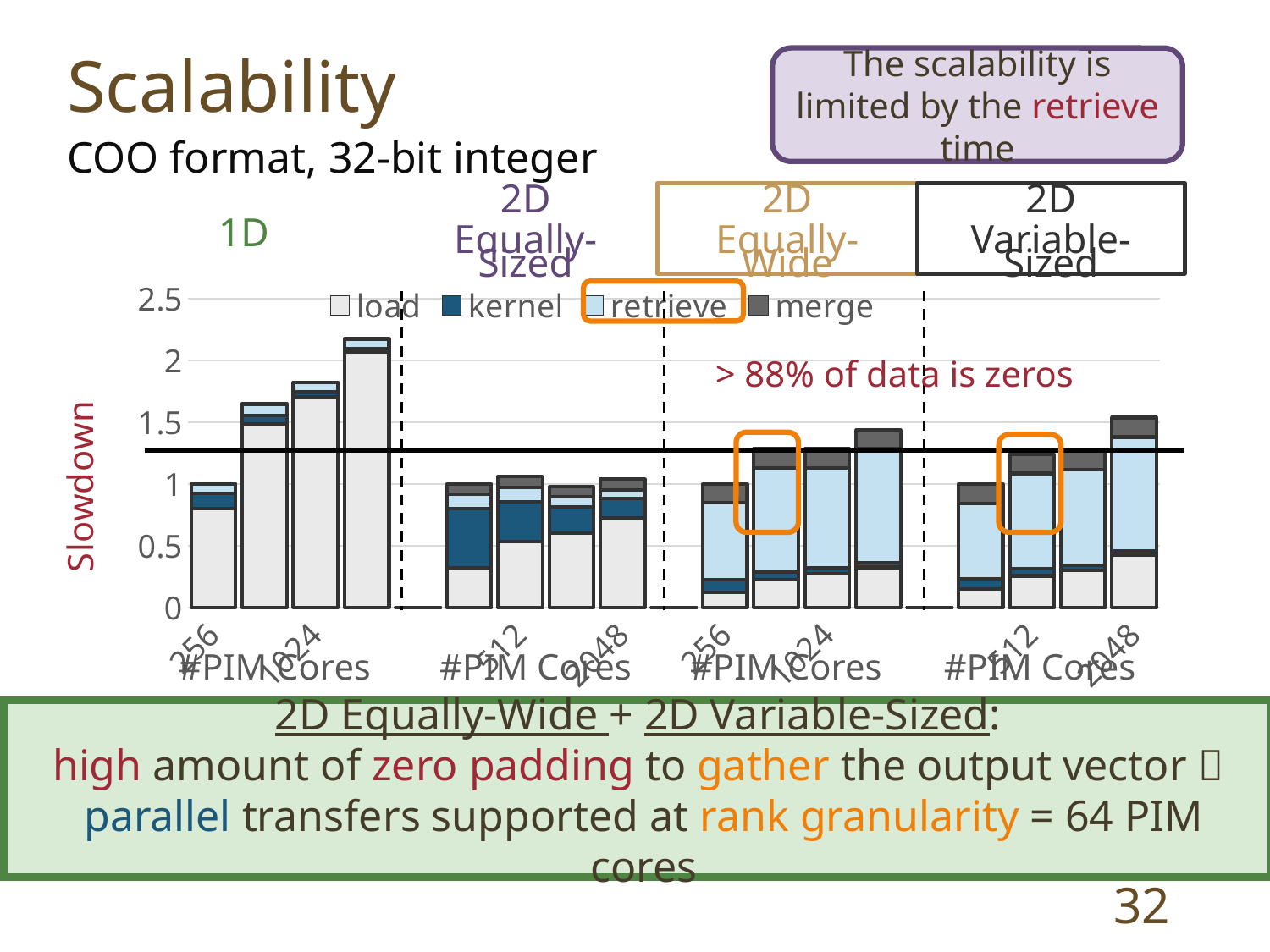
How many bar groups (configurations) are shown in the chart? 4 Is the total slowdown for 2048 PIM cores in the 2D Equally-Wide group greater or less than 1.5? less What are the four series named in the chart legend? load, kernel, retrieve, merge How many bars are in the 1D group of the chart? 4 In the 1D group, does the slowdown rise or fall as the number of PIM cores increases? rise Is the total slowdown for 2048 PIM cores in the 1D group greater or less than 2? greater Which configuration group contains the tallest bar in the chart? 1D What is the label on the vertical axis of the chart? Slowdown What kind of chart is shown on the slide? stacked bar chart Is the total slowdown for 1024 PIM cores in the 1D group greater or less than 1.5? greater How many series does the chart legend list? 4 Which is larger: the total slowdown at 2048 PIM cores for 1D or for 2D Equally-Sized? 1D